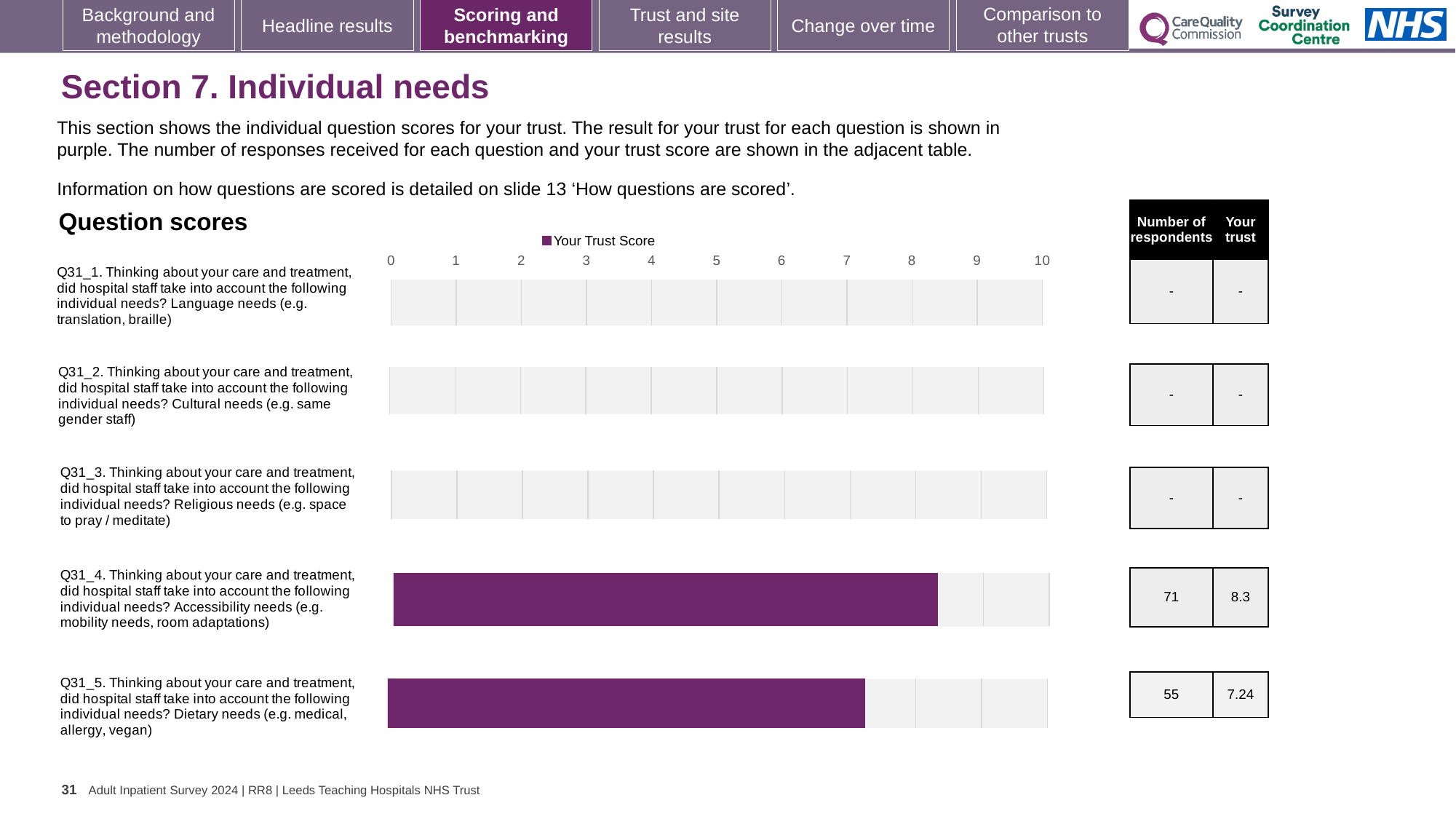
Which question has the highest trust score shown on the chart? Q31_4 (Accessibility needs) Which has the larger trust score, Q31_4 (Accessibility needs) or Q31_5 (Dietary needs)? Q31_4 (Accessibility needs) How many series does the chart legend list? 1 What is the trust score for Q31_4 (Accessibility needs)? 8.3 What is the difference between the trust scores for Q31_4 and Q31_5? 1.06 How many questions are listed on the chart? 5 How many respondents answered Q31_5 (Dietary needs)? 55 What is the trust score for Q31_5 (Dietary needs)? 7.24 How many respondents answered Q31_4 (Accessibility needs)? 71 Is the trust score for Q31_5 (Dietary needs) greater or less than 7? greater What kind of chart is shown on the slide? Bar chart Is the trust score for Q31_4 (Accessibility needs) greater or less than 8? greater